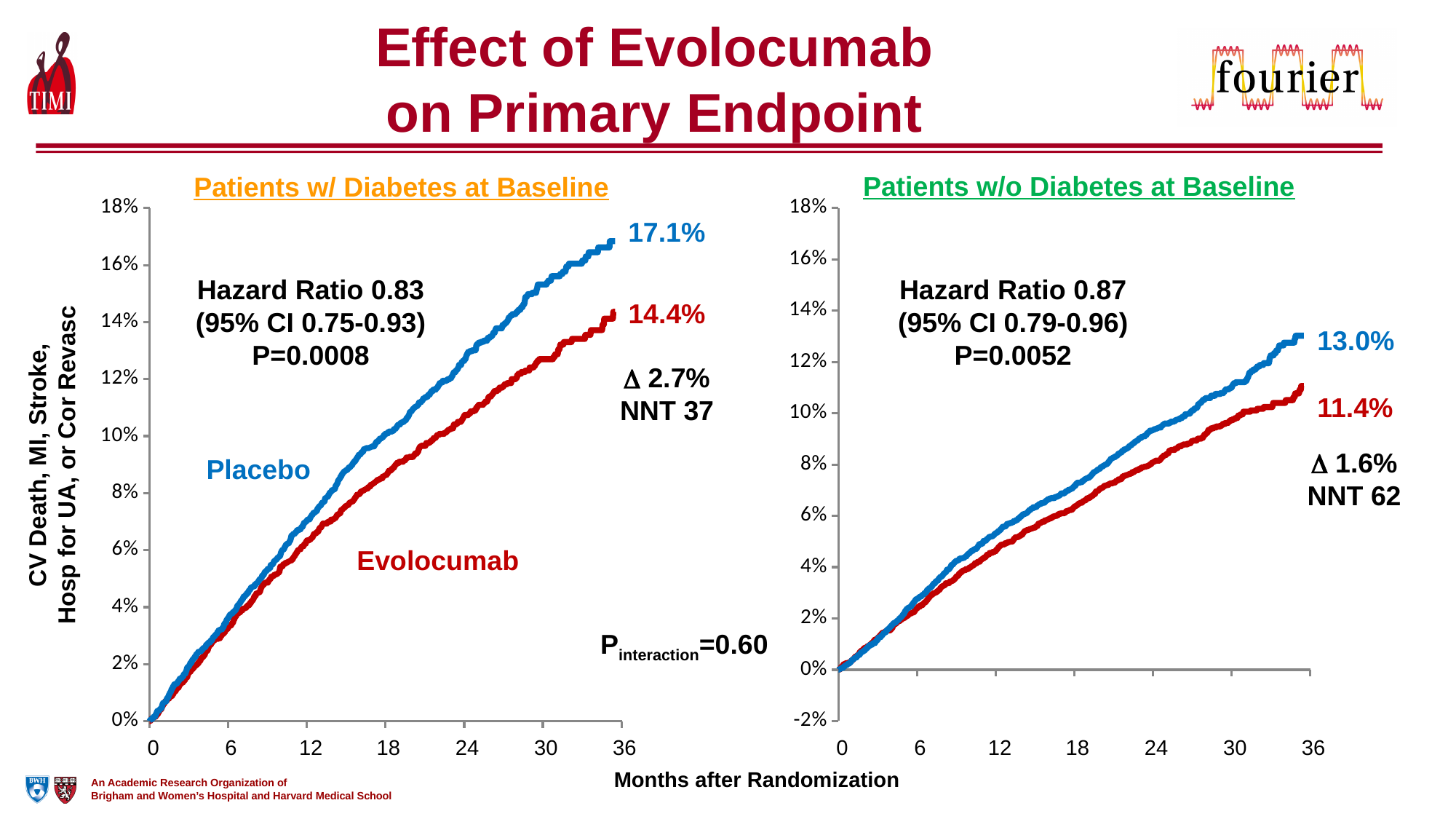
In the 'Patients w/ Diabetes at Baseline' chart, what is the difference between the Placebo and Evolocumab final event rates? 2.7% What kind of chart is the 'Patients w/ Diabetes at Baseline' chart? Line chart In the 'Patients w/o Diabetes at Baseline' chart, what is the final event rate for the Evolocumab group? 11.4% In the 'Patients w/o Diabetes at Baseline' chart, do the event rates rise or fall as months after randomization increase? Rise How many groups (lines) are plotted in the 'Patients w/ Diabetes at Baseline' chart? 2 In the 'Patients w/o Diabetes at Baseline' chart, what is the final event rate for the Placebo group? 13.0% In the 'Patients w/o Diabetes at Baseline' chart, which group has the lower final event rate? Evolocumab In the 'Patients w/ Diabetes at Baseline' chart, what colour is the Evolocumab line? Red In the 'Patients w/ Diabetes at Baseline' chart, which group has the higher final event rate, Placebo or Evolocumab? Placebo In the 'Patients w/o Diabetes at Baseline' chart, what is the difference between the Placebo and Evolocumab final event rates? 1.6% In the 'Patients w/ Diabetes at Baseline' chart, what is the final event rate for the Placebo group? 17.1% In the 'Patients w/ Diabetes at Baseline' chart, what is the final event rate for the Evolocumab group? 14.4%